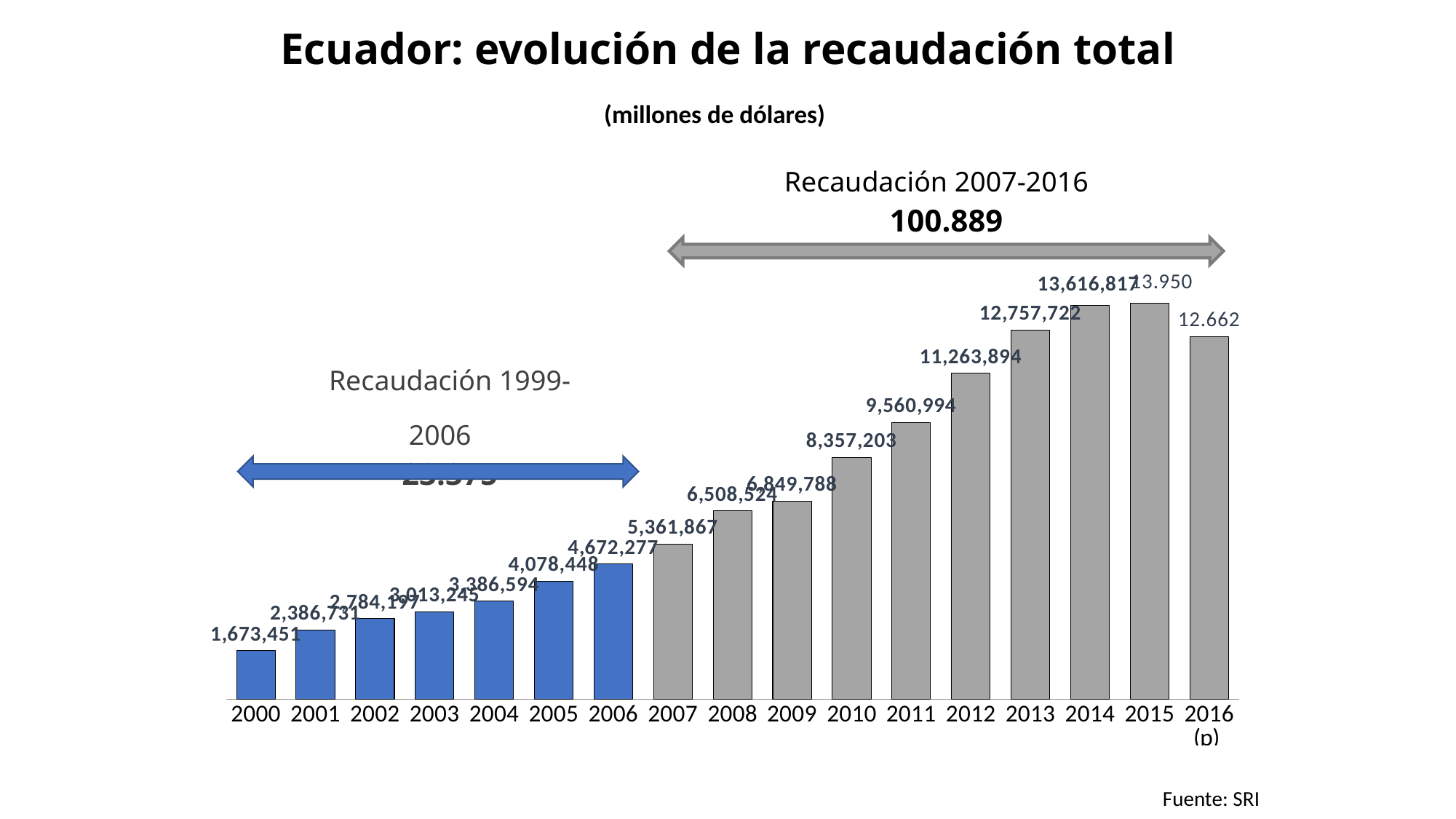
What total is given for Recaudación 2007-2016 above the chart? 100.889 Do the values generally rise or fall from 2000 to 2015? Rise Which is larger, the value for 2013 or the value for 2016 (p)? 2013 What is the value for 2007? 5,361,867 Which year has the highest bar? 2015 What is the value for 2011? 9,560,994 What is the value for 2016 (p)? 12.662 What is the difference between the values for 2007 and 2006? 689,590 How many years (bars) are shown in the chart? 17 Which year has the lowest bar? 2000 What is the value for 2000? 1,673,451 What type of chart is shown on the slide? Bar chart